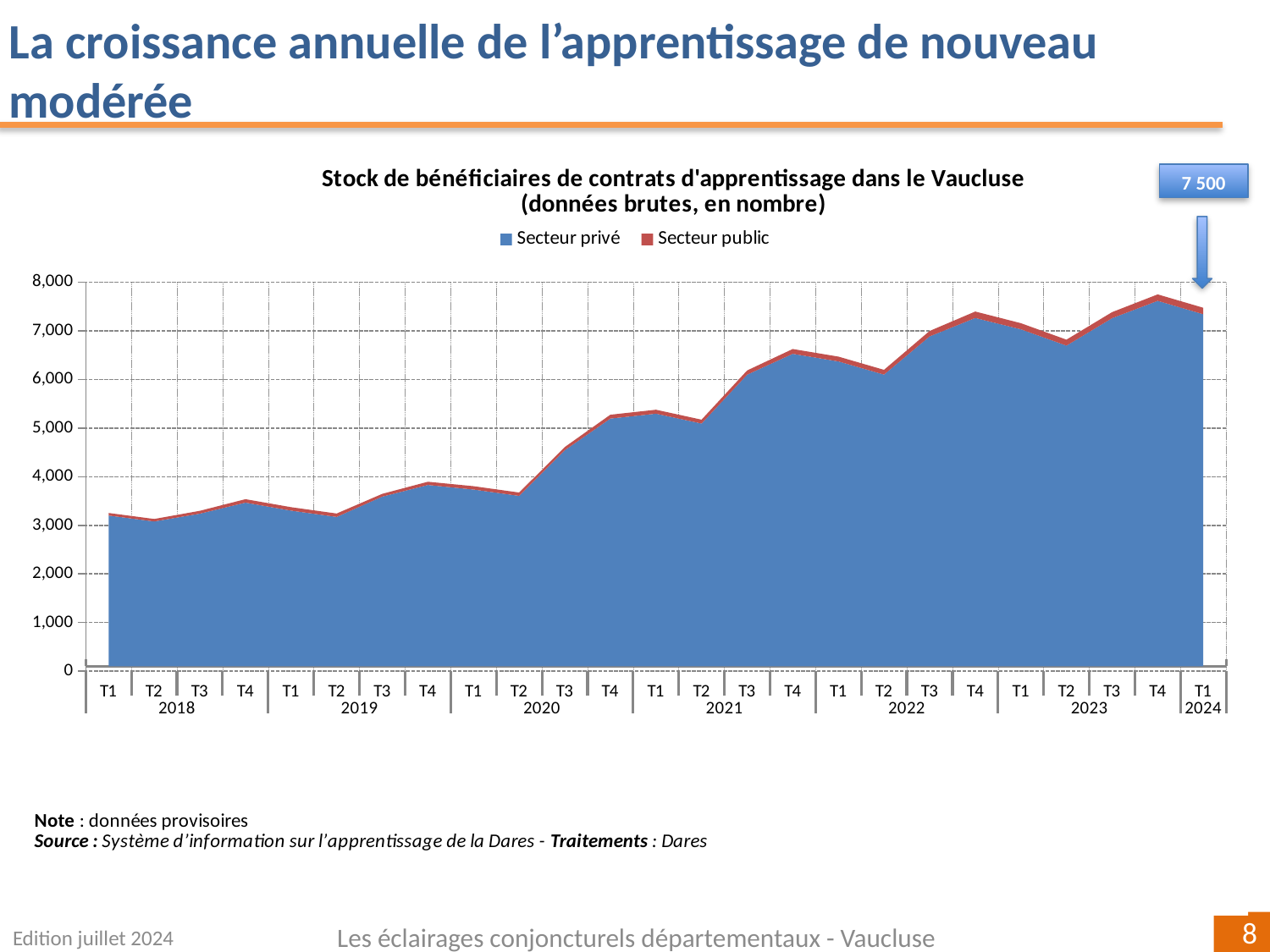
What kind of chart is shown on the slide? Stacked area chart How many quarterly points are plotted along the x axis? 25 Is the total value for T3 2020 greater or less than 4,000? greater What are the two series named in the legend? Secteur privé and Secteur public Is the total value for T1 2018 greater or less than 4,000? less How many series does the chart legend list? 2 Is the total value for T4 2022 greater or less than 7,000? greater What total value is indicated by the callout for T1 2024? 7 500 Overall, do the values rise or fall from T1 2018 to T1 2024? Rise Which series accounts for the larger share of the stock, Secteur privé or Secteur public? Secteur privé Which is larger, the total for T4 2021 or the total for T2 2022? T4 2021